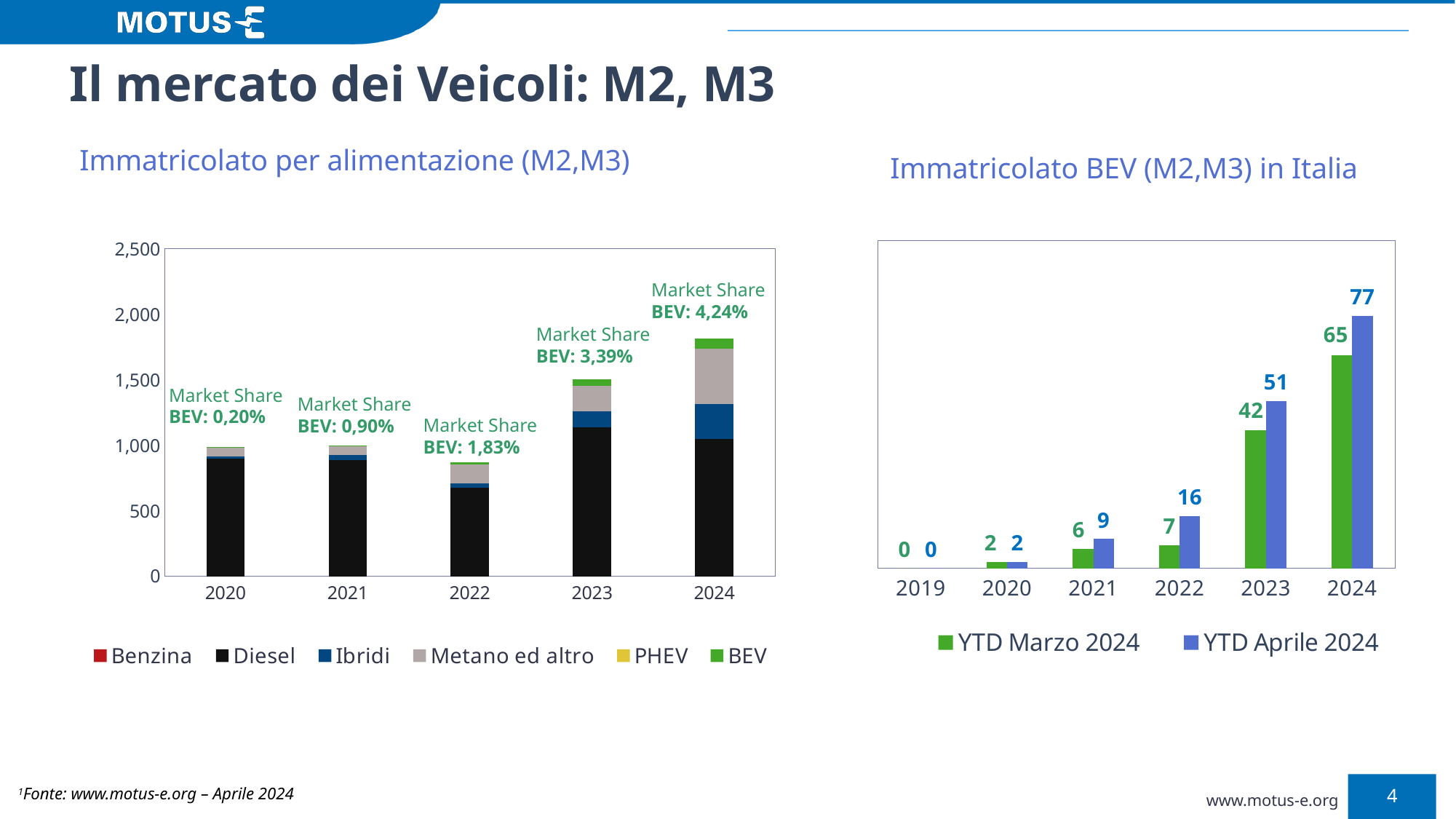
In the chart 'Immatricolato BEV (M2,M3) in Italia', how many years are shown on the x axis? 6 In the chart 'Immatricolato BEV (M2,M3) in Italia', which is larger in 2021: YTD Marzo 2024 or YTD Aprile 2024? YTD Aprile 2024 In the chart 'Immatricolato BEV (M2,M3) in Italia', what is the difference between the YTD Aprile 2024 and YTD Marzo 2024 values in 2022? 9 In the chart 'Immatricolato per alimentazione (M2,M3)', what is the BEV market share shown for 2024? BEV: 4,24% In the chart 'Immatricolato BEV (M2,M3) in Italia', which year has the highest YTD Aprile 2024 value? 2024 In the chart 'Immatricolato per alimentazione (M2,M3)', is the total stacked bar for 2024 greater or less than 1,500? greater In the chart 'Immatricolato BEV (M2,M3) in Italia', what is the value for YTD Aprile 2024 in 2024? 77 In the chart 'Immatricolato BEV (M2,M3) in Italia', how many series does the legend list? 2 In the chart 'Immatricolato per alimentazione (M2,M3)', how many series does the legend list? 6 In the chart 'Immatricolato per alimentazione (M2,M3)', which year has the lowest BEV market share? 2020 In the chart 'Immatricolato BEV (M2,M3) in Italia', what is the value for YTD Marzo 2024 in 2023? 42 In the chart 'Immatricolato BEV (M2,M3) in Italia', do the YTD Aprile 2024 values rise or fall from 2019 to 2024? rise